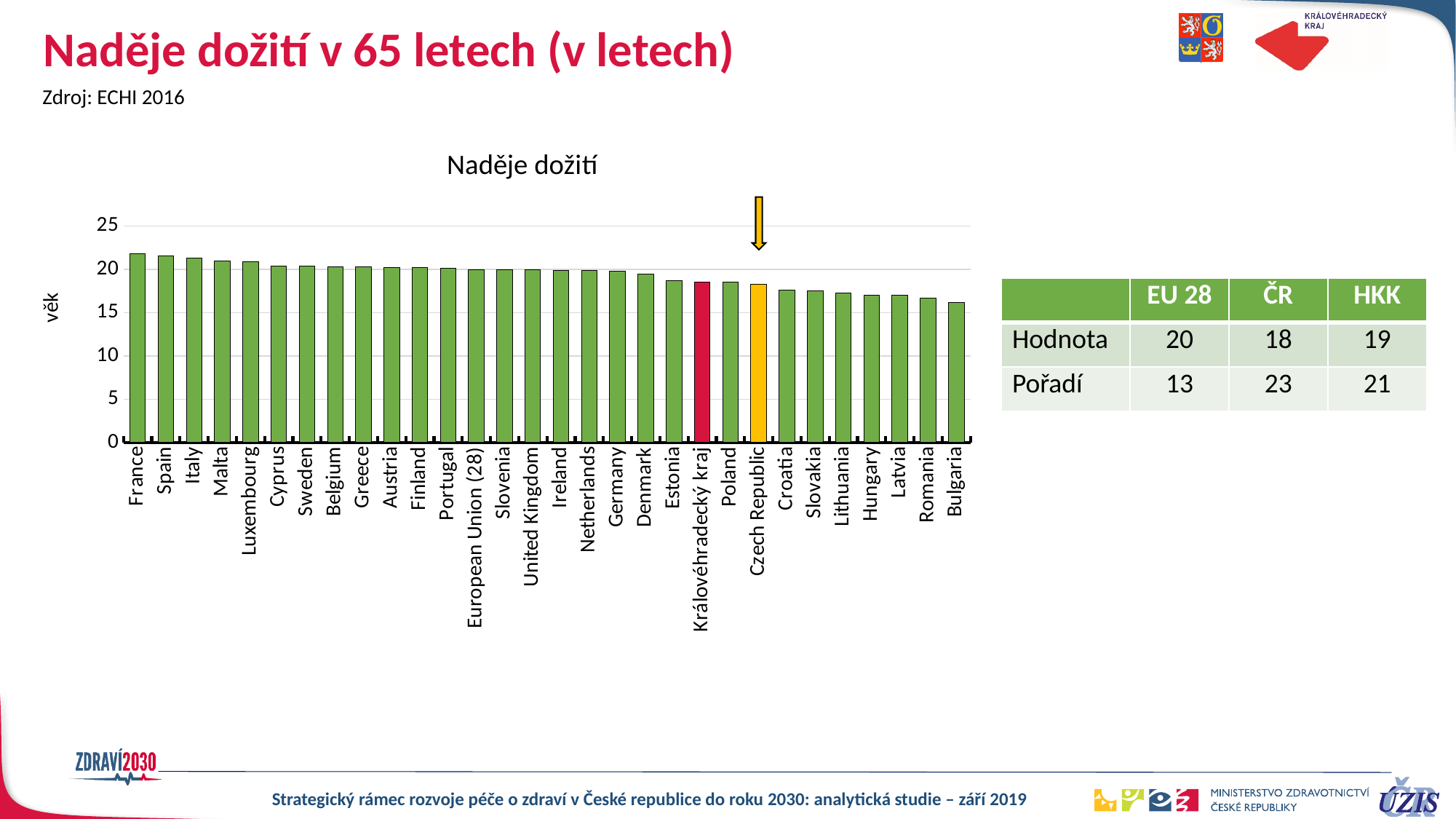
What colour is the bar for Czech Republic? yellow How many categories (bars) are plotted in the chart? 30 Is the value for Malta greater or less than 20? greater Is the value for Czech Republic greater or less than 20? less Do the values rise or fall moving from left to right along the x axis? fall What kind of chart is shown on the slide? bar chart Is the value for Bulgaria greater or less than 20? less What is the title of the chart? Naděje dožití Which is larger, the value for Estonia or the value for Croatia? Estonia Which category has the lowest value in the chart? Bulgaria Which category has the highest value in the chart? France